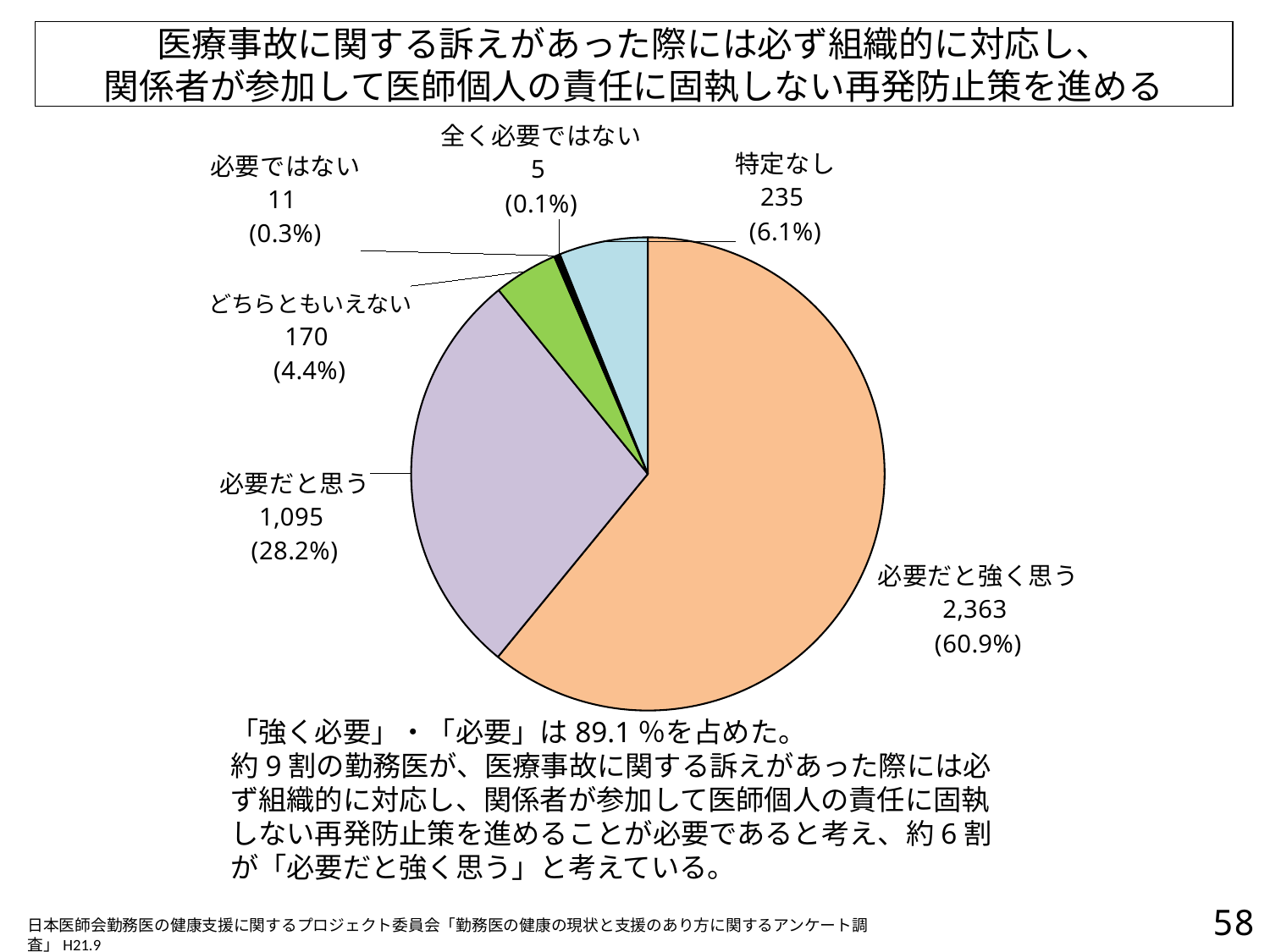
What is the count for 必要だと強く思う? 2,363 What kind of chart is shown on the slide? Pie chart Which category has the smallest slice of the pie? 全く必要ではない How many categories does the pie chart show? 6 What is the count for 必要ではない? 11 What percentage share does 必要だと思う have? 28.2% Which category has the largest slice of the pie? 必要だと強く思う What is the difference in count between 必要だと強く思う and 必要だと思う? 1,268 What is the count for 特定なし? 235 What percentage is shown for どちらともいえない? 4.4% What is the combined count of 必要ではない and 全く必要ではない? 16 Which is larger, the count for 特定なし or the count for どちらともいえない? 特定なし